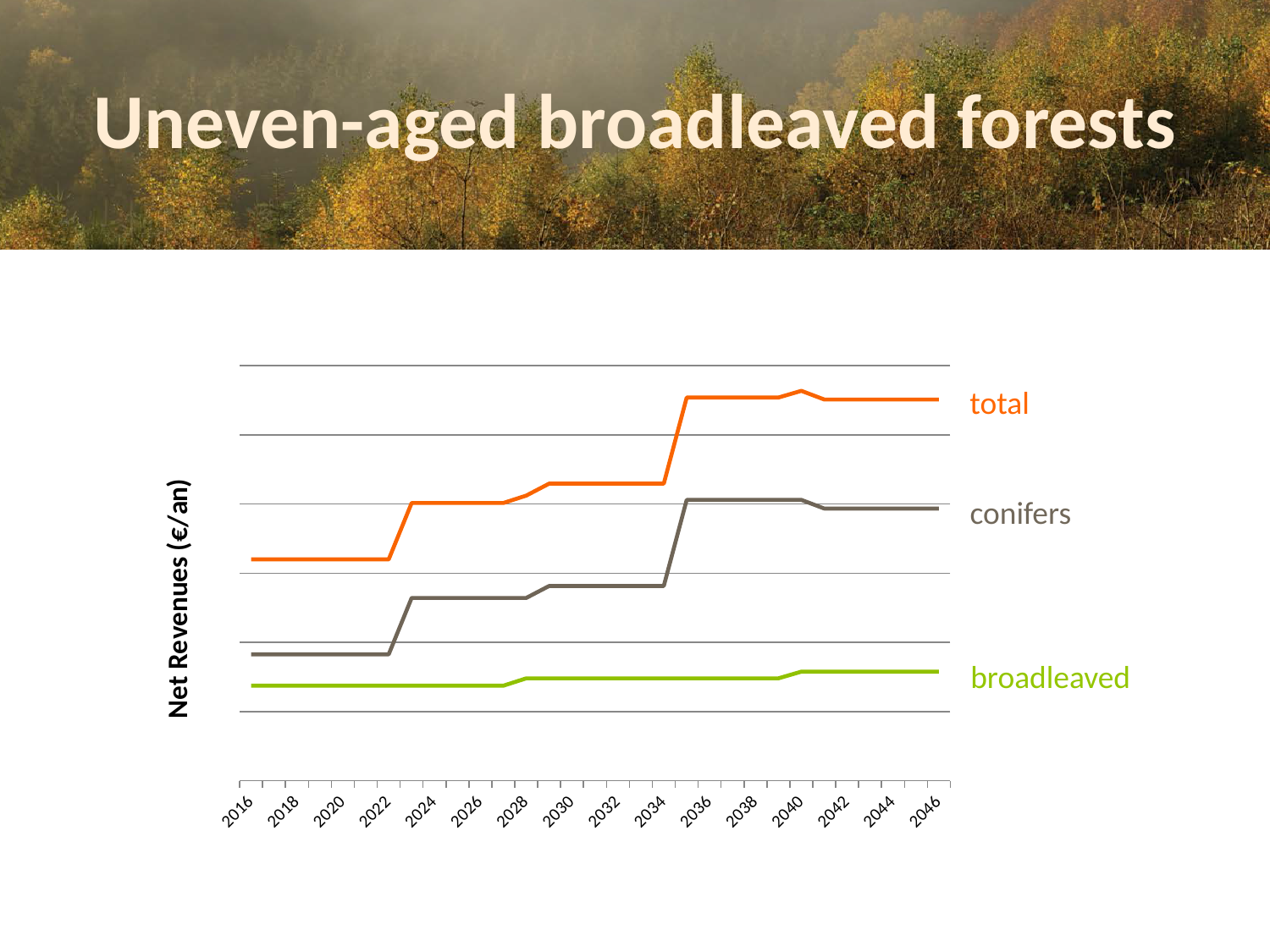
What is the last year shown on the x axis? 2046 How many series are plotted on the chart? 3 What kind of chart is shown on the slide? line chart Which series has the lowest values across the chart? broadleaved What is the label of the y axis? Net Revenues (€/an) What is the title of the slide containing the chart? Uneven-aged broadleaved forests Do the values of the total series rise or fall from 2016 to 2046? rise Which series has the highest values across the chart? total Do the values of the conifers series rise or fall from 2016 to 2036? rise Which series is higher in 2030, total or conifers? total What is the first year shown on the x axis? 2016 Which series is higher in 2040, conifers or broadleaved? conifers